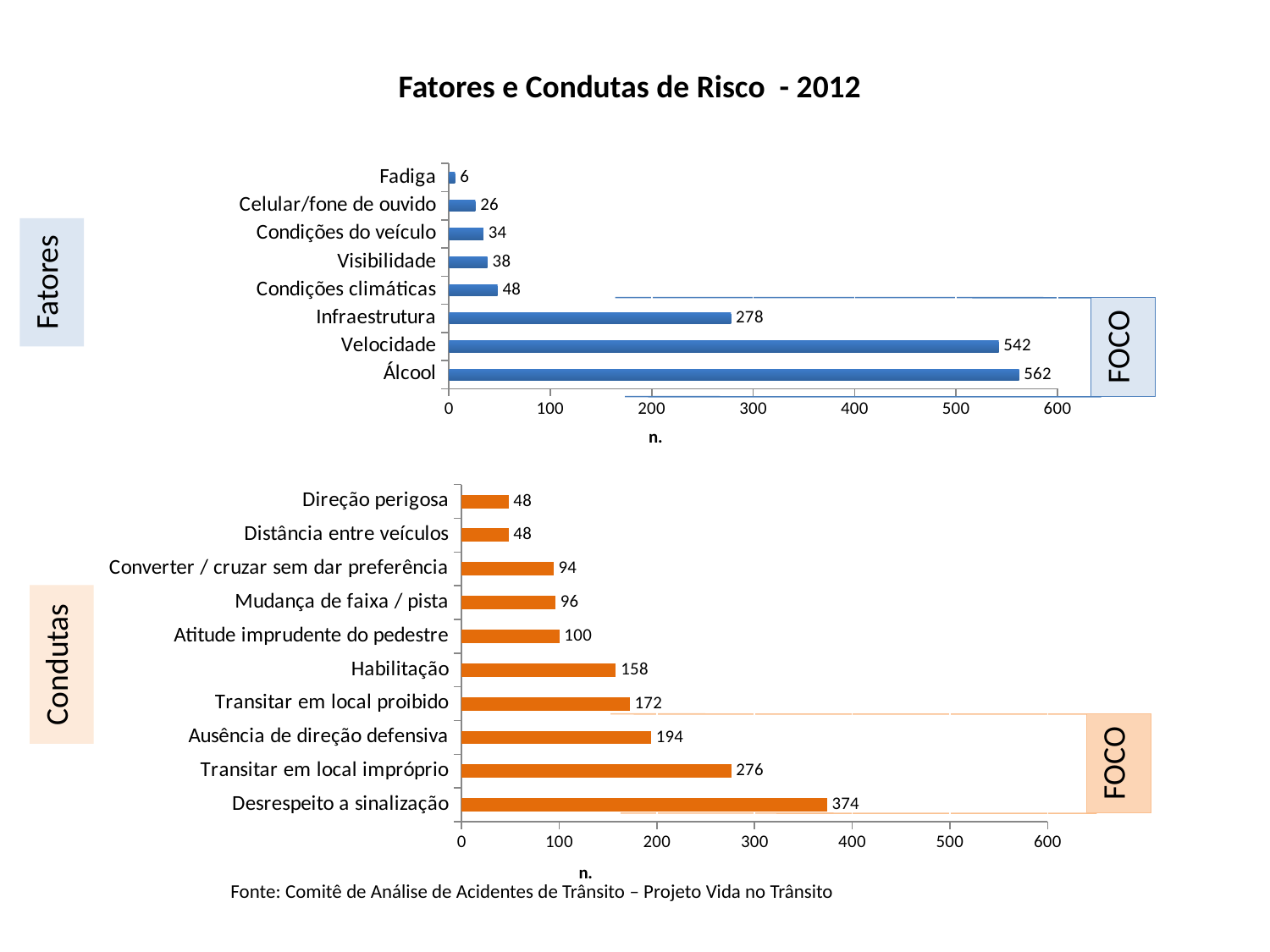
In the Fatores chart (top), which category has the highest value? Álcool In the Condutas chart (bottom), what is the value for Transitar em local impróprio? 276 In the Fatores chart (top), which category has the lowest value? Fadiga In the Fatores chart (top), how many categories are shown? 8 In the Condutas chart (bottom), how many categories are shown? 10 In the Condutas chart (bottom), what is the difference between Desrespeito a sinalização and Ausência de direção defensiva? 180 What type of chart is the Condutas chart (bottom)? Bar chart In the Condutas chart (bottom), which category has the highest value? Desrespeito a sinalização In the Condutas chart (bottom), which is larger: Habilitação or Transitar em local proibido? Transitar em local proibido In the Fatores chart (top), what is the value for Condições climáticas? 48 In the Fatores chart (top), what is the value for Velocidade? 542 In the Fatores chart (top), what is the difference between Álcool and Velocidade? 20